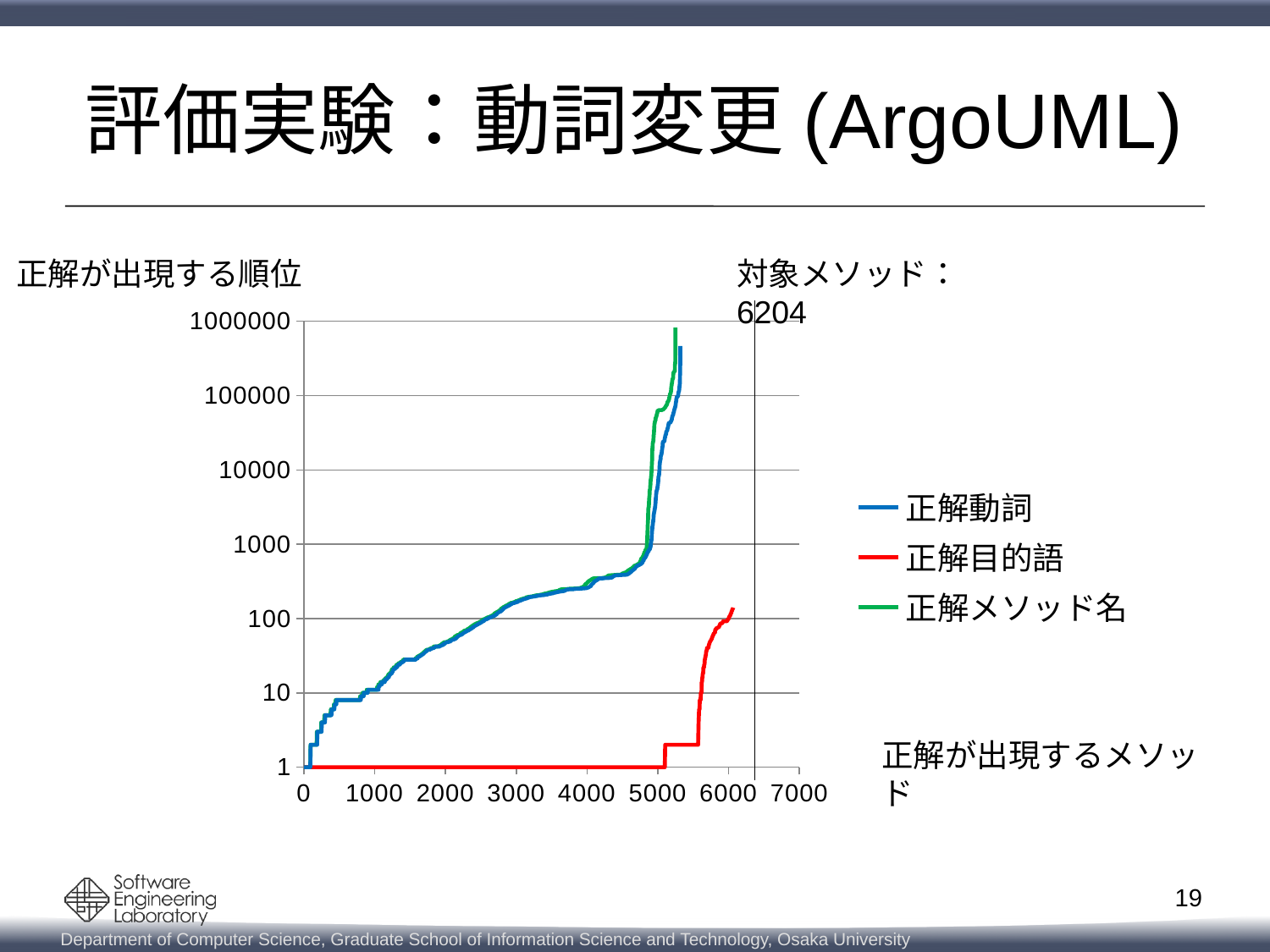
Is the value of 正解動詞 at x = 3000 greater or less than 100? greater What kind of chart is shown on the slide? line chart Do the values of 正解動詞 rise or fall as x increases? rise Which series reaches the highest value on the chart? 正解メソッド名 At x = 4000, which series has the larger value, 正解動詞 or 正解目的語? 正解動詞 Is the highest value reached by 正解メソッド名 greater or less than 100000? greater Which series stays lowest across the chart? 正解目的語 Is the value of 正解目的語 at x = 3000 greater or less than 10? less How many series does the legend list? 3 Which series is drawn in red in the legend? 正解目的語 What is the highest value shown on the y axis? 1000000